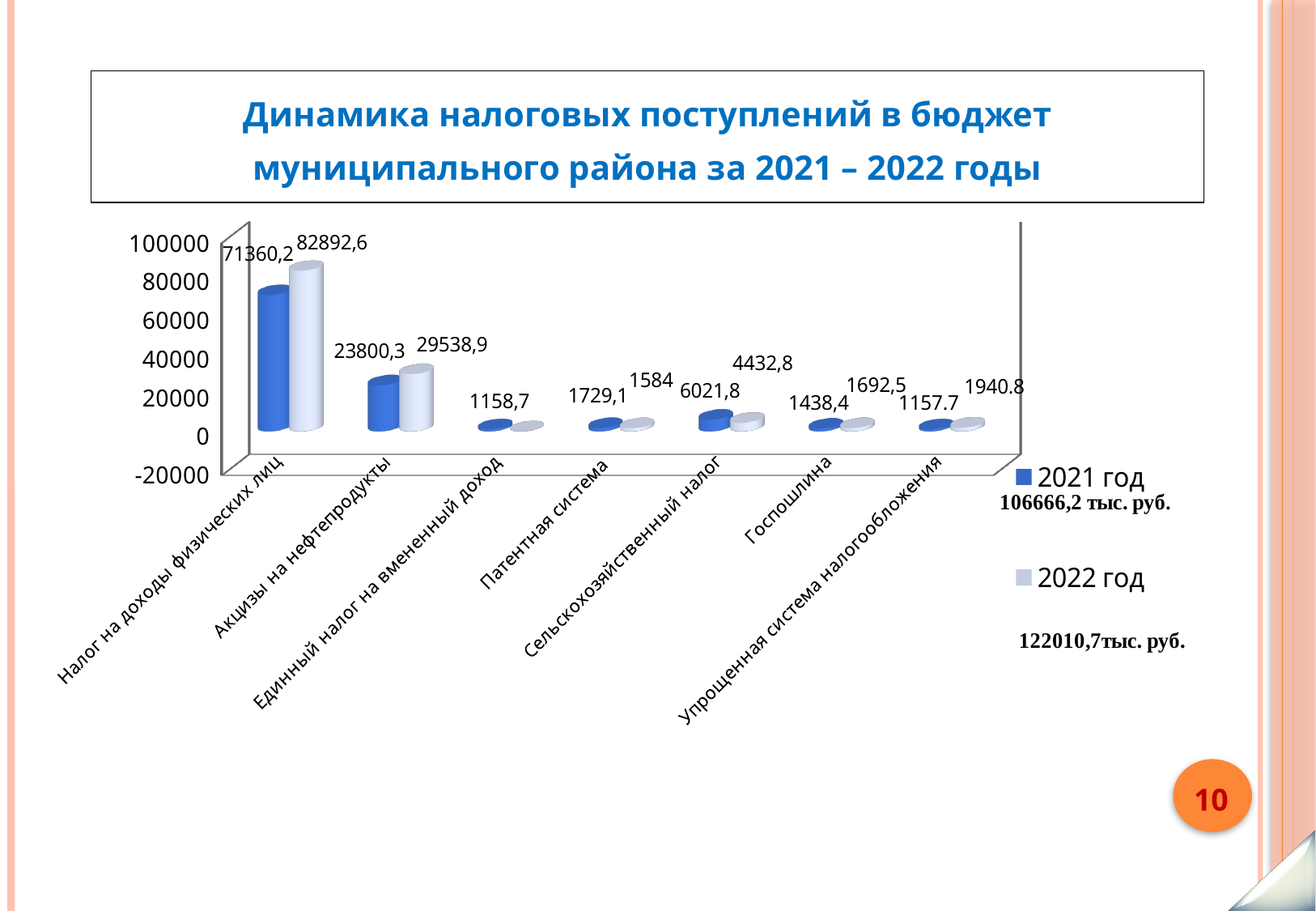
For Патентная система, which year has the larger value, 2021 год or 2022 год? 2021 год How many series does the legend list? 2 How many tax categories are shown on the x axis? 7 What is the difference between the 2022 год and 2021 год values for Акцизы на нефтепродукты? 5738,6 Which category has the highest 2021 год value? Налог на доходы физических лиц For Сельскохозяйственный налог, which year has the larger value, 2021 год or 2022 год? 2021 год By how much did Налог на доходы физических лиц increase from 2021 год to 2022 год? 11532,4 What is the 2022 год value for Госпошлина? 1692,5 What is the 2022 год value for Налог на доходы физических лиц? 82892,6 What is the 2021 год value for Акцизы на нефтепродукты? 23800,3 What is the 2021 год value for Сельскохозяйственный налог? 6021,8 What type of chart is shown on the slide? Bar chart